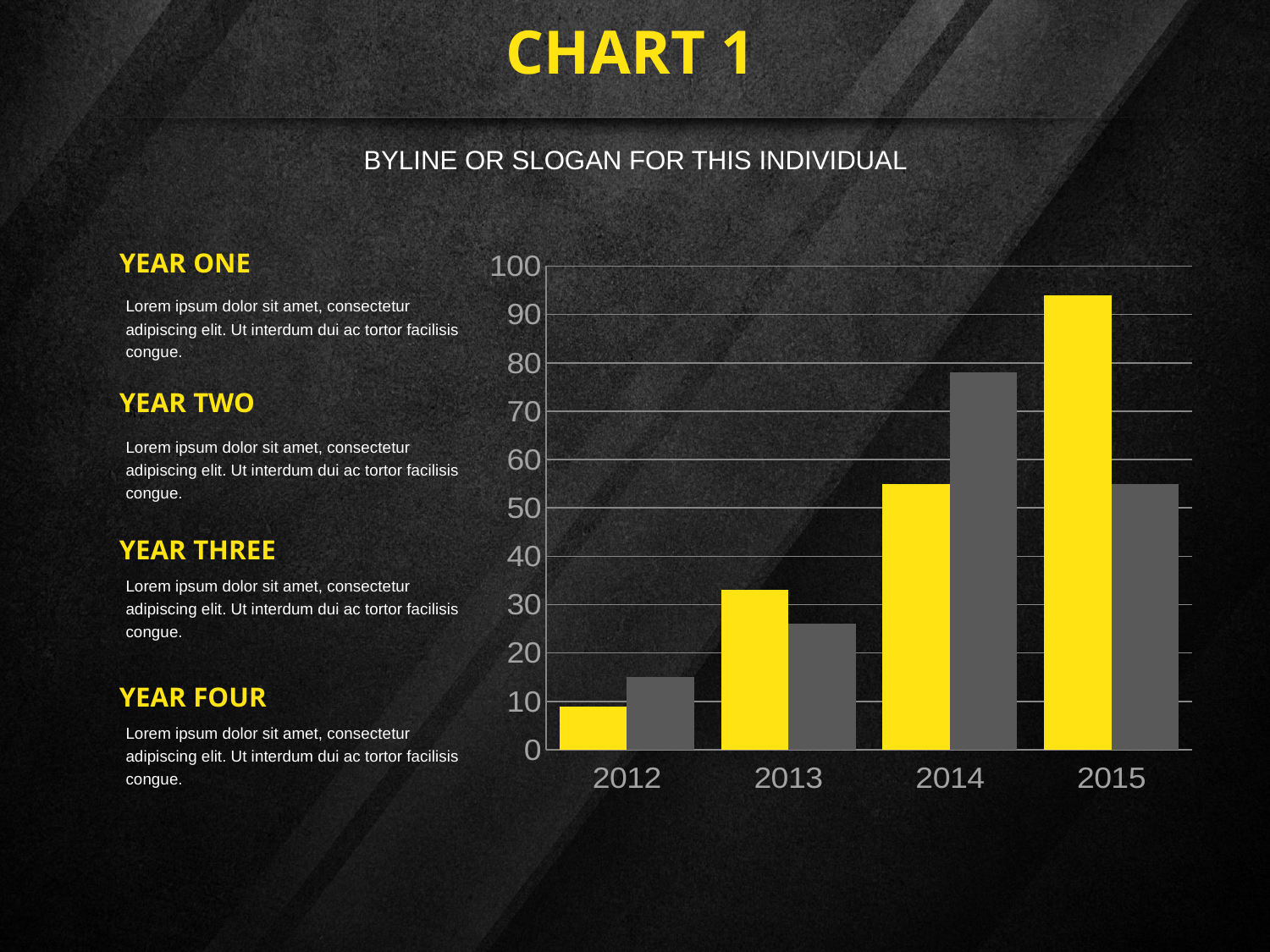
Is the yellow bar for 2012 greater or less than 10? less Is the yellow bar for 2015 greater or less than 90? greater In 2012, which bar is taller, the yellow or the gray one? gray Is the gray bar for 2013 greater or less than 30? less Which year has the shortest yellow bar? 2012 How many years are shown on the x axis of the chart? 4 What kind of chart is shown on the slide? bar chart In 2015, which bar is taller, the yellow or the gray one? yellow Do the yellow bars rise or fall from 2012 to 2015? rise Which year has the tallest gray bar? 2014 Which year has the tallest yellow bar? 2015